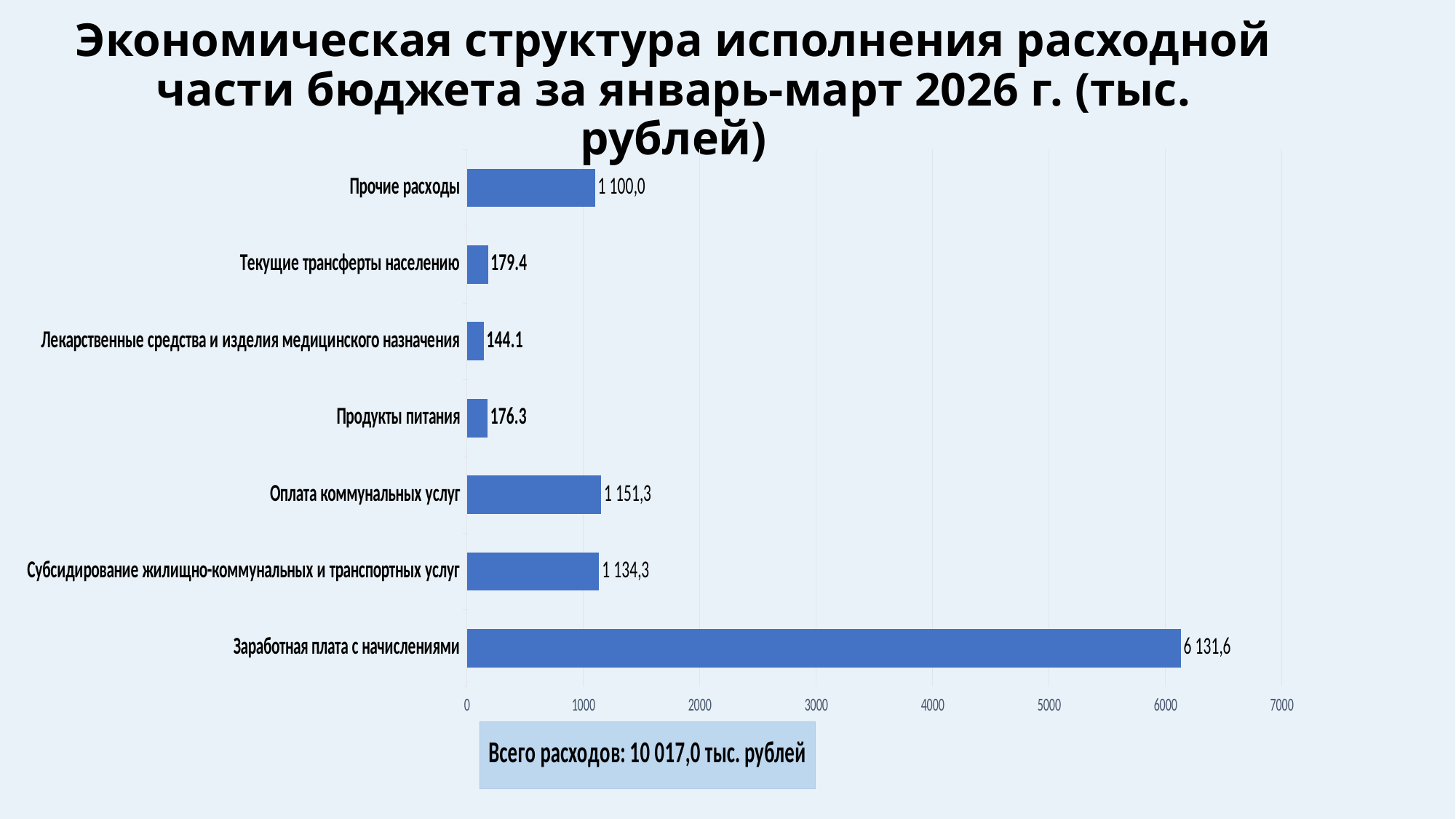
Which category has the highest value? Заработная плата с начислениями Is the value for Заработная плата с начислениями greater or less than 6000? greater What is the value for Прочие расходы? 1 100,0 What total expenditure is stated in the box below the chart? 10 017,0 тыс. рублей Which category has the lowest value? Лекарственные средства и изделия медицинского назначения What kind of chart is shown on the slide? bar chart Which is larger: Текущие трансферты населению or Продукты питания? Текущие трансферты населению What is the value for Заработная плата с начислениями? 6 131,6 What is the value for Оплата коммунальных услуг? 1 151,3 What is the difference between Оплата коммунальных услуг and Субсидирование жилищно-коммунальных и транспортных услуг? 17,0 How many categories are shown in the chart? 7 What is the value for Лекарственные средства и изделия медицинского назначения? 144.1